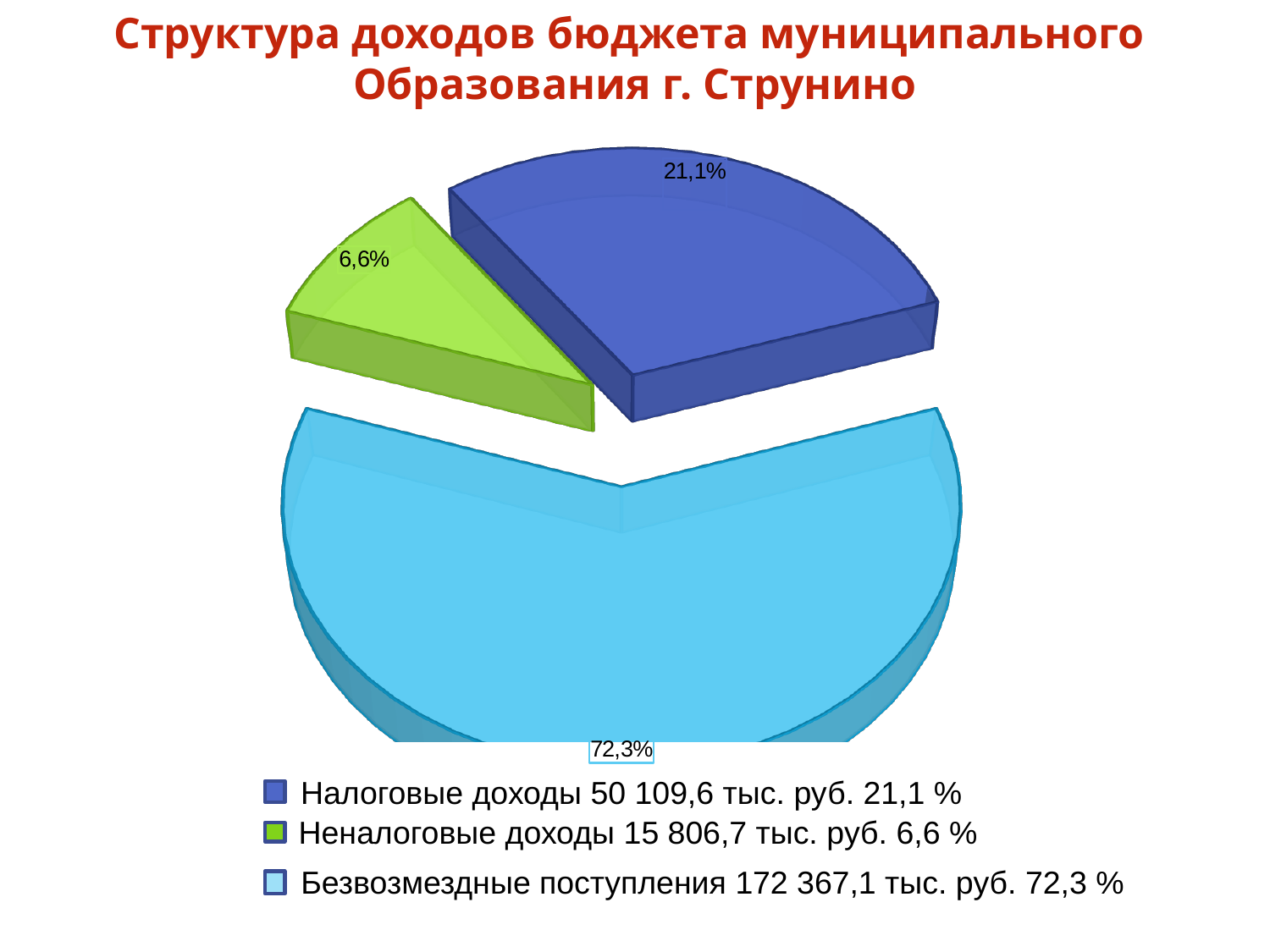
What colour is the slice for Неналоговые доходы? green Which slice is larger: Налоговые доходы or Неналоговые доходы? Налоговые доходы What share of the pie does Налоговые доходы represent? 21,1% What amount in тыс. руб. does the legend give for Неналоговые доходы? 15 806,7 тыс. руб. What amount in тыс. руб. does the legend give for Безвозмездные поступления? 172 367,1 тыс. руб. Which category has the largest slice of the pie? Безвозмездные поступления How many slices does the pie chart have? 3 What type of chart is shown on the slide? pie chart What is the difference in percentage points between the Безвозмездные поступления slice and the Налоговые доходы slice? 51,2 Which category has the smallest slice of the pie? Неналоговые доходы What share of the pie does Безвозмездные поступления represent? 72,3% What share of the pie does Неналоговые доходы represent? 6,6%